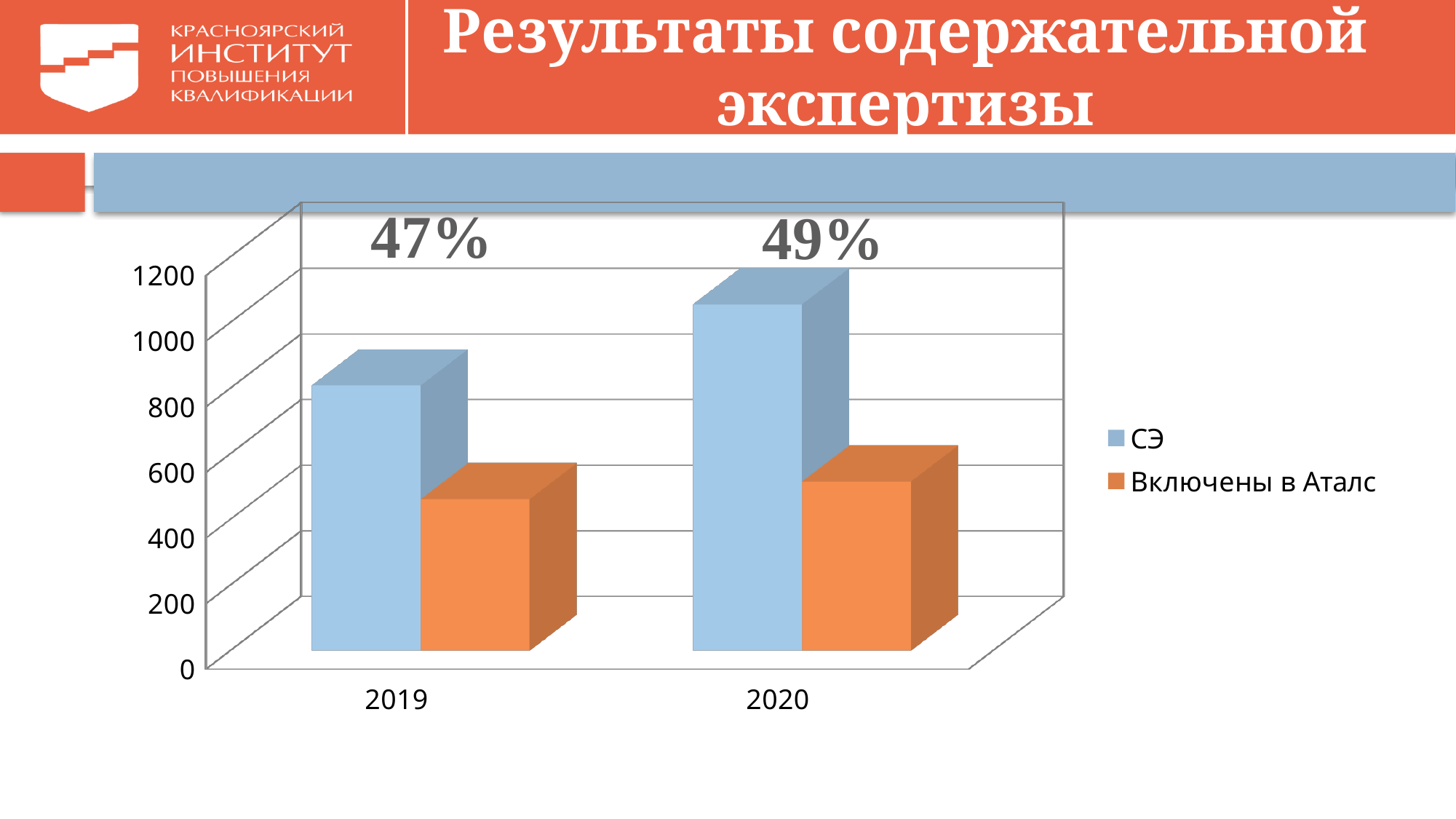
How many series does the legend list? 2 In 2019, which series has the taller bar, СЭ or Включены в Аталс? СЭ How many year categories are shown on the x axis? 2 Is the value for СЭ in 2020 greater or less than 800? greater Is the value for Включены в Аталс in 2019 greater or less than 800? less What kind of chart is shown on the slide? bar chart Does the СЭ series rise or fall from 2019 to 2020? rise Which year has the taller СЭ bar, 2019 or 2020? 2020 Is the value for СЭ in 2019 greater or less than 600? greater What percentage label is printed above the 2020 bars? 49% What percentage label is printed above the 2019 bars? 47% What colour are the bars for the series Включены в Аталс? orange